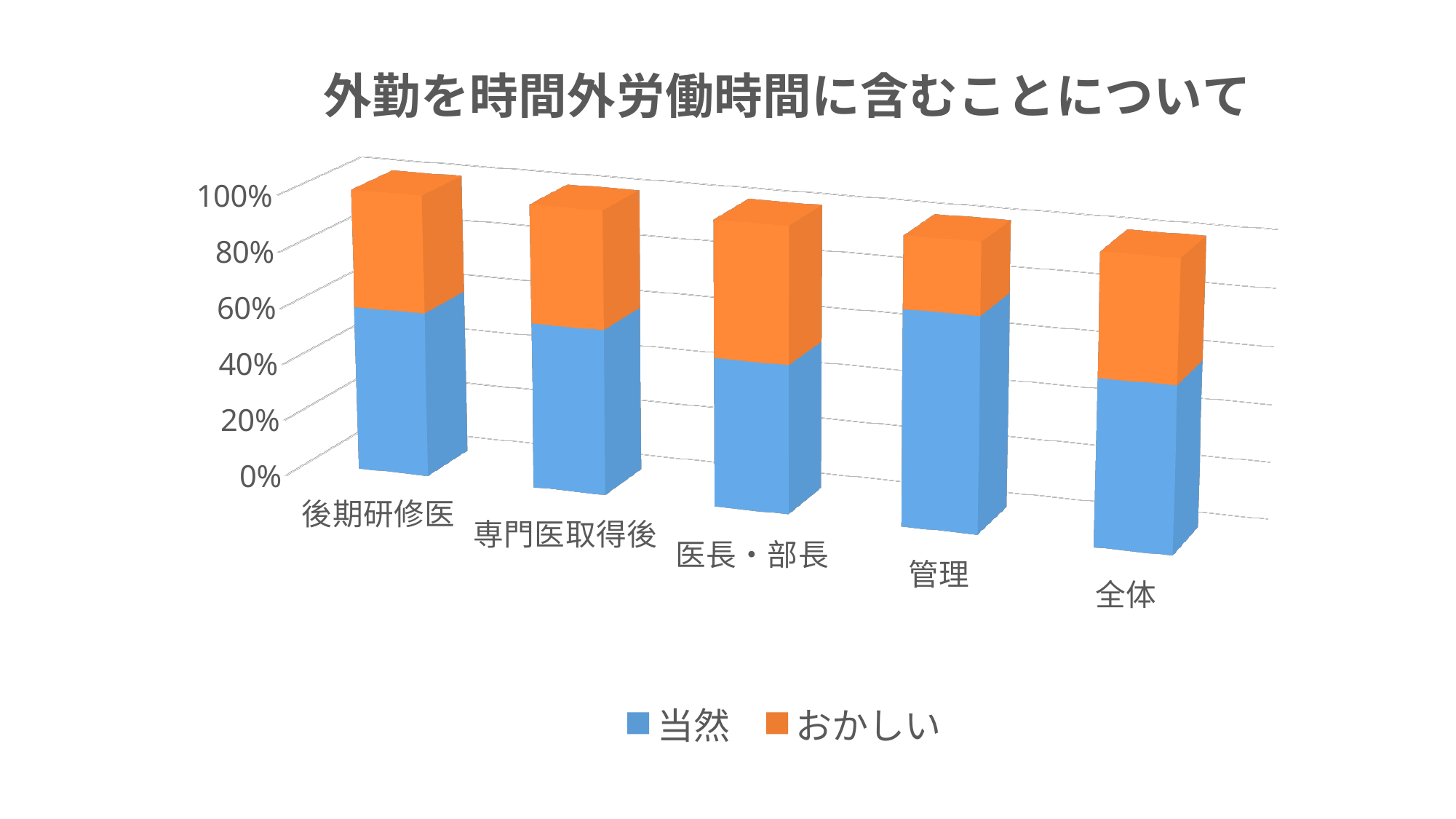
Which series is shown in orange in the chart? おかしい How many categories are shown on the x axis of the chart? 5 Which has the larger 当然 share, 管理 or 医長・部長? 管理 Which has the larger おかしい share, 医長・部長 or 管理? 医長・部長 Is the おかしい share for 管理 greater or less than 40%? less Is the 当然 share for 管理 greater or less than 60%? greater Is the 当然 share for 後期研修医 greater or less than 40%? greater What is the total of the stacked bar for 全体? 100% What kind of chart is shown on the slide? stacked bar chart What is the title of the chart? 外勤を時間外労働時間に含むことについて Which category has the highest share of 当然? 管理 How many series does the legend list? 2